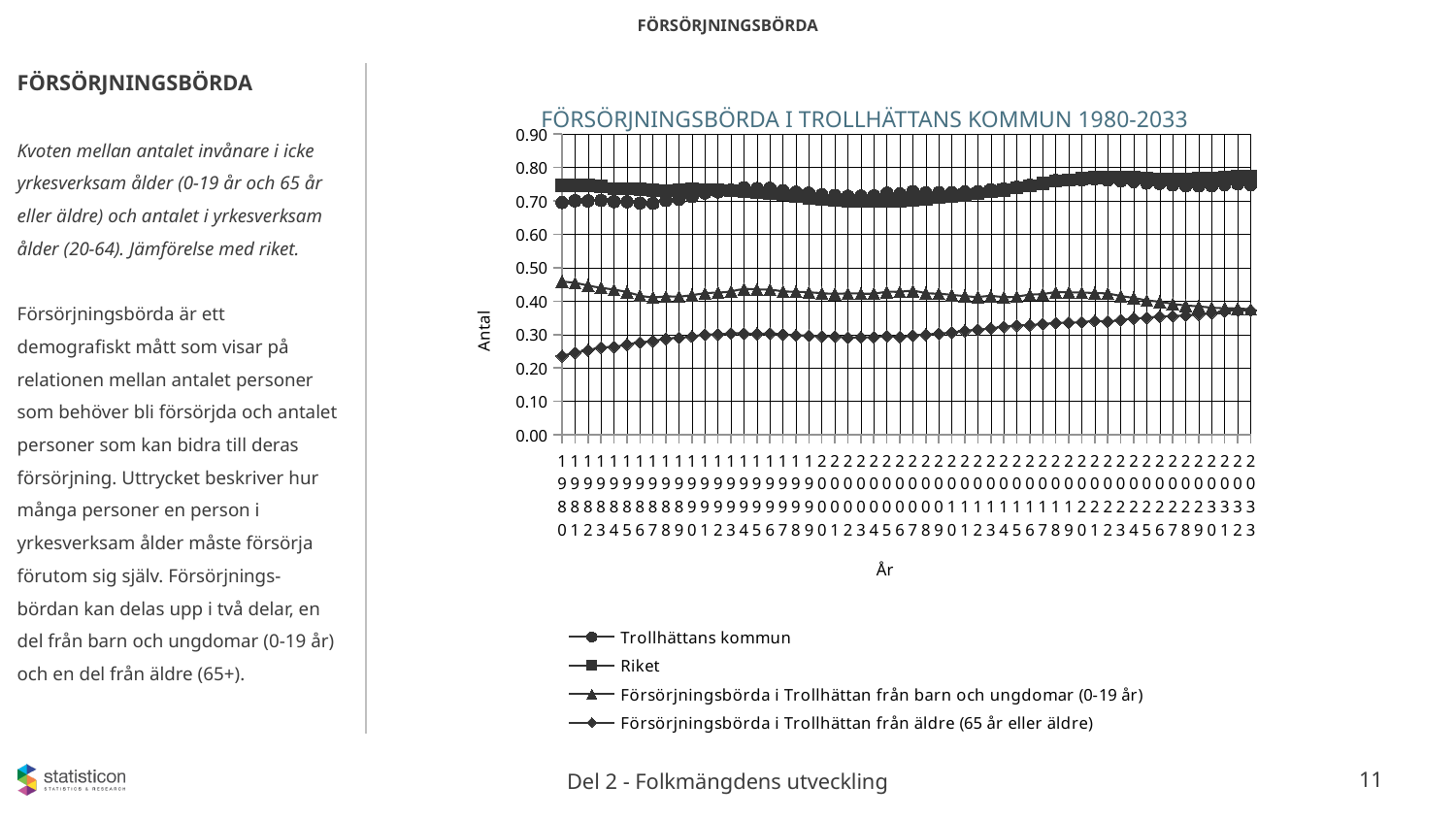
Is the value for Försörjningsbörda i Trollhättan från barn och ungdomar (0-19 år) in 1980 greater or less than 0.40? greater Is the value for Försörjningsbörda i Trollhättan från äldre (65 år eller äldre) in 2033 greater or less than 0.30? greater In 1980, which is larger: Försörjningsbörda i Trollhättan från barn och ungdomar (0-19 år) or Försörjningsbörda i Trollhättan från äldre (65 år eller äldre)? Försörjningsbörda i Trollhättan från barn och ungdomar (0-19 år) What kind of chart is shown on the slide? line chart What is the title of the chart? FÖRSÖRJNINGSBÖRDA I TROLLHÄTTANS KOMMUN 1980-2033 Which series has the highest value in 1980? Riket Is the value for Riket in 1980 greater or less than 0.70? greater What is the label on the vertical axis of the chart? Antal Which series has the lowest value in 1980? Försörjningsbörda i Trollhättan från äldre (65 år eller äldre) How many series does the legend list? 4 Does the series Försörjningsbörda i Trollhättan från äldre (65 år eller äldre) rise or fall from 1980 to 2033? rise